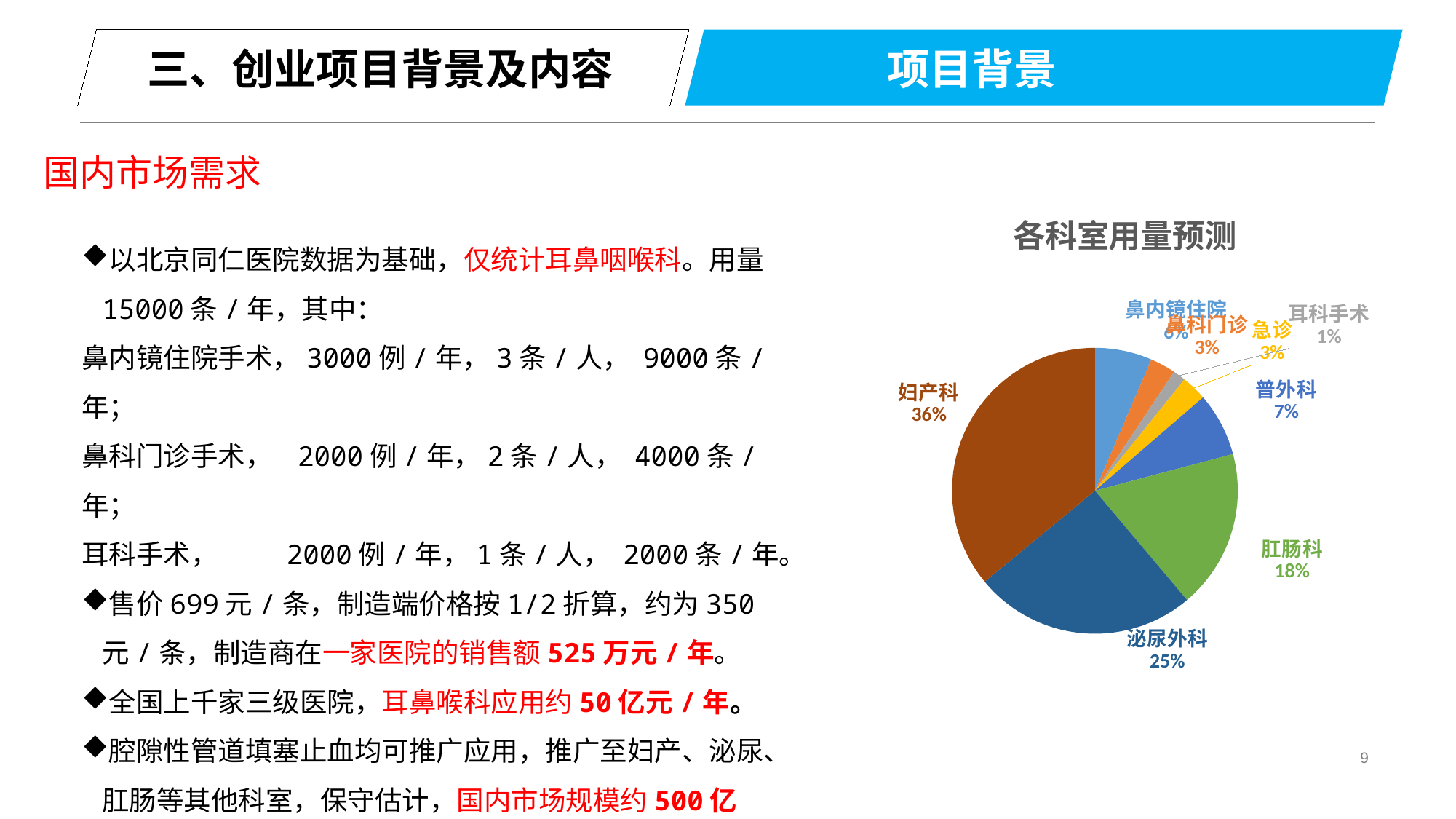
Which department has the smallest slice of the pie? 耳科手术 What share of the pie does 妇产科 account for? 36% What is the value shown for 普外科? 7% What is the difference in percentage points between 妇产科 and 泌尿外科? 11 What is the value shown for 耳科手术? 1% What is the value shown for 肛肠科? 18% What kind of chart is shown on the slide? pie chart What is the title of the chart? 各科室用量预测 What is the value shown for 泌尿外科? 25% Which department has the largest slice of the pie? 妇产科 Which is larger, the slice for 肛肠科 or the slice for 普外科? 肛肠科 How many slices does the pie chart have? 8